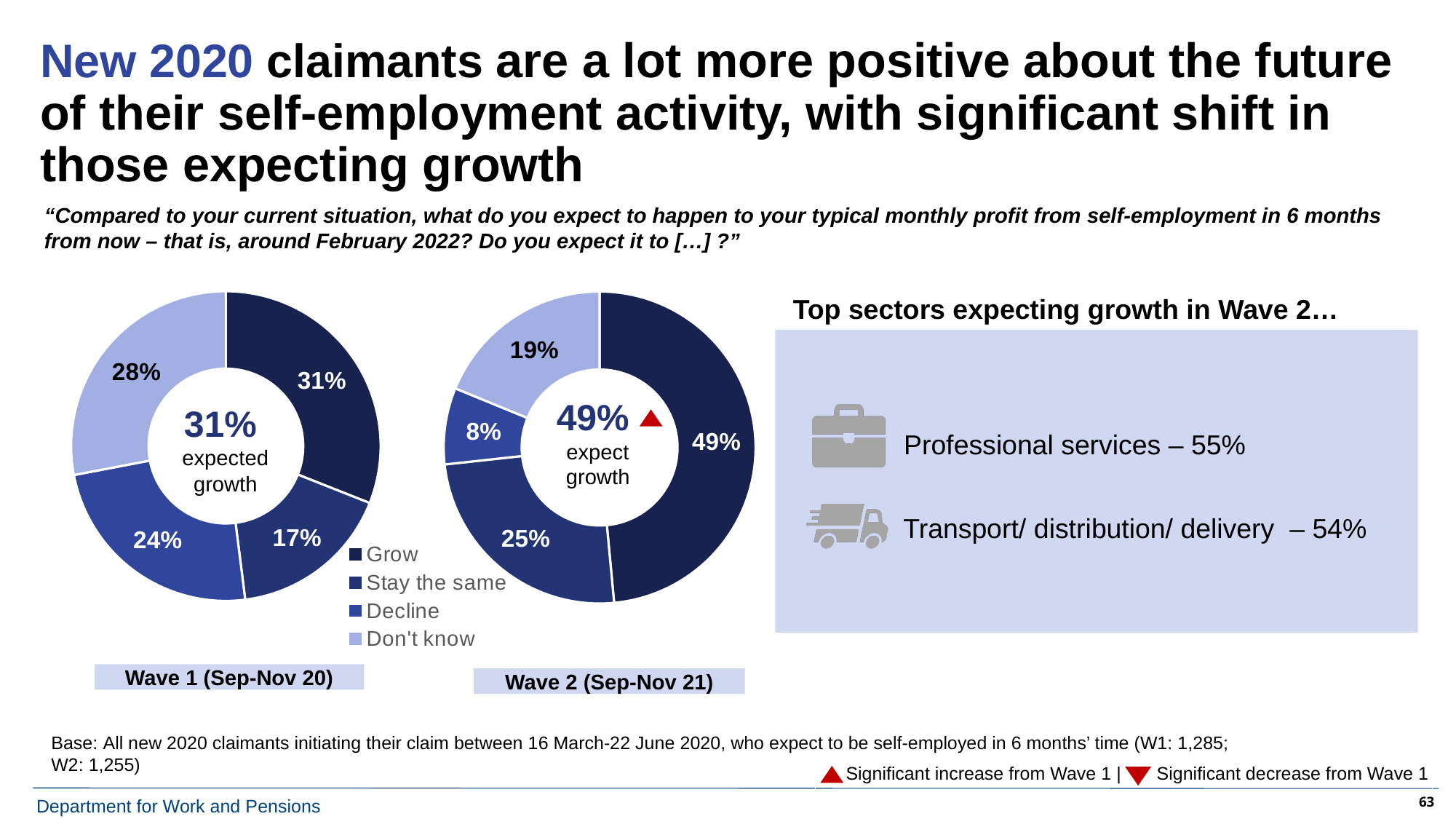
In the Wave 2 (Sep-Nov 21) chart, what percentage of claimants expect their profit to decline? 8% In the Wave 2 (Sep-Nov 21) chart, which response category has the smallest share? Decline In the Wave 2 (Sep-Nov 21) chart, which response category has the largest share? Grow What is the difference in percentage points between the 'Grow' share in Wave 2 (Sep-Nov 21) and in Wave 1 (Sep-Nov 20)? 18 percentage points In the Wave 1 (Sep-Nov 20) chart, what percentage of claimants expect their profit to stay the same? 17% In the Wave 1 (Sep-Nov 20) chart, which is larger: the 'Decline' share or the 'Stay the same' share? Decline In the Wave 1 (Sep-Nov 20) chart, which response category has the smallest share? Stay the same In the Wave 2 (Sep-Nov 21) chart, what percentage of claimants expect their profit to grow? 49% How many response categories does the legend list for the donut charts? 4 What type of chart is used to show the Wave 1 and Wave 2 results? Donut (pie) chart In the Wave 1 (Sep-Nov 20) chart, what percentage of claimants answered 'Don't know'? 28% In the Wave 1 (Sep-Nov 20) chart, what percentage of claimants expect their profit to grow? 31%